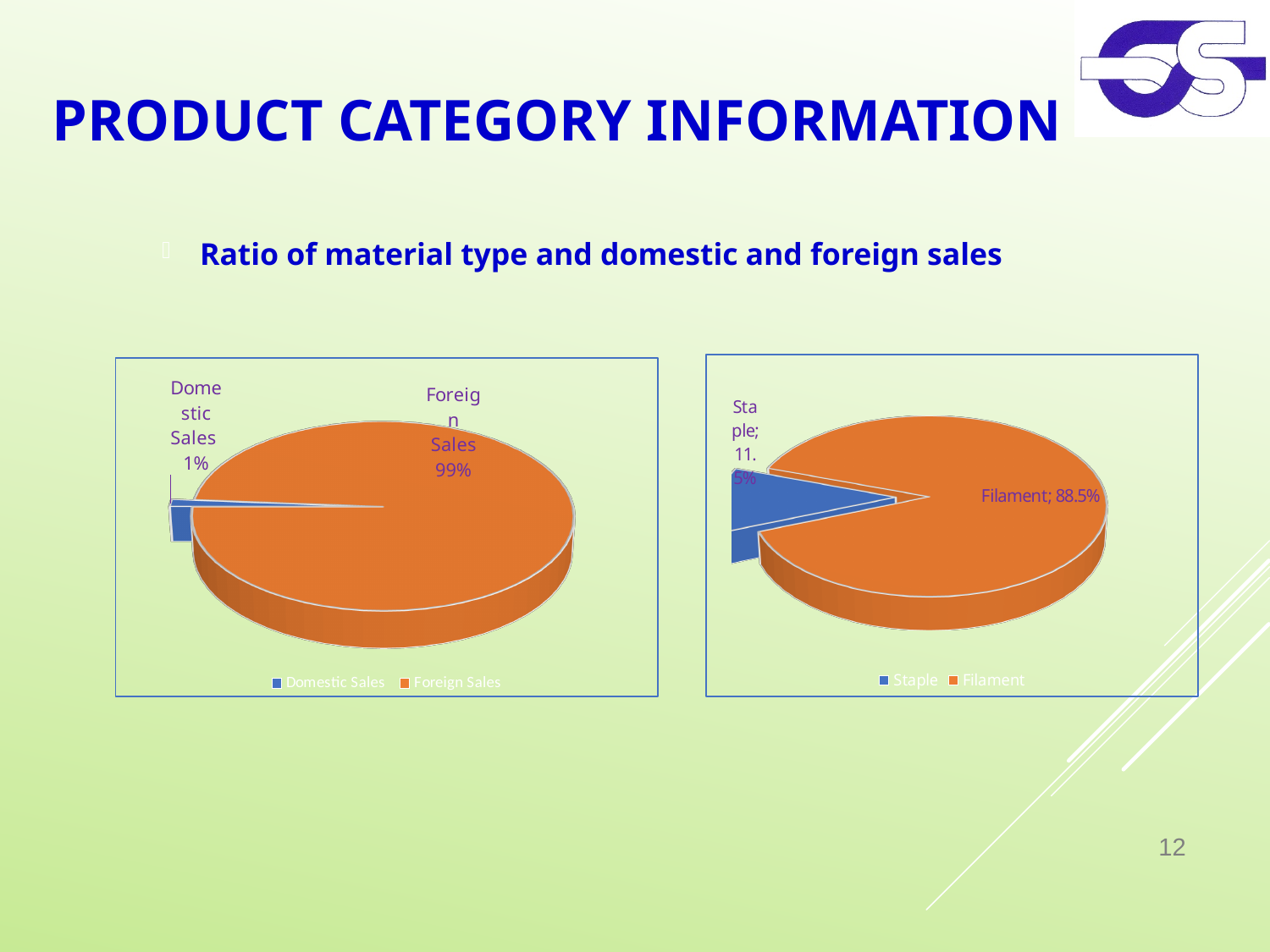
In the right pie chart, which slice is the smallest? Staple In the right pie chart, what share is labelled for Staple? 11.5% In the right pie chart, what share is labelled for Filament? 88.5% In the right pie chart, what is the difference in percentage points between Filament and Staple? 77 percentage points In the right pie chart, which is larger, Staple or Filament? Filament How many slices does the left pie chart have? 2 What entries does the legend of the right pie chart list? Staple, Filament In the left pie chart, which slice is the largest? Foreign Sales In the left pie chart, what share is labelled for Domestic Sales? 1% In the left pie chart, what is the difference in percentage points between Foreign Sales and Domestic Sales? 98 percentage points What type of chart is the right chart on the slide? Pie chart In the left pie chart, what share is labelled for Foreign Sales? 99%